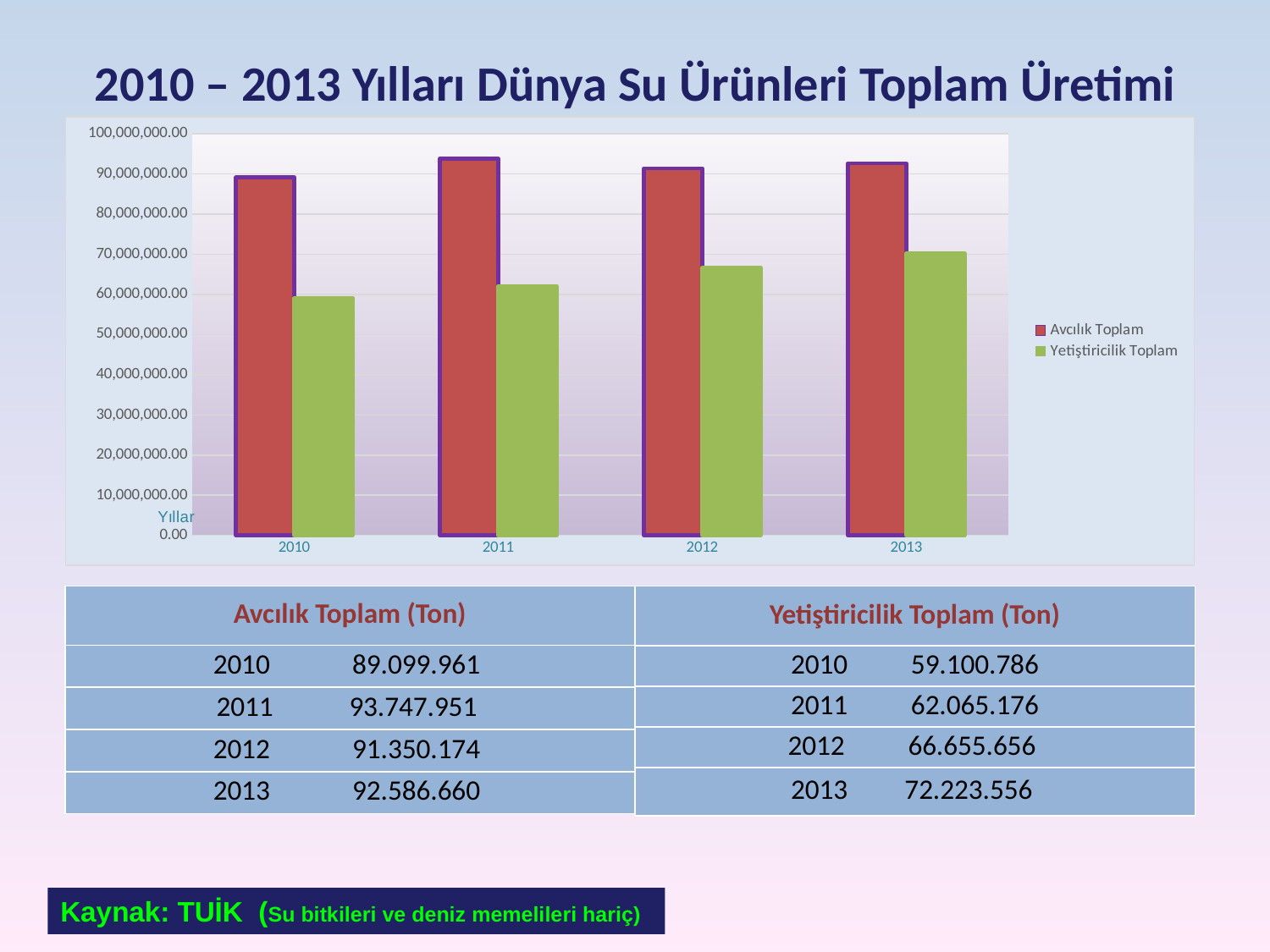
How many years are shown on the x axis of the chart? 4 In which year is Avcılık Toplam highest? 2011 In 2012, which is larger: Avcılık Toplam or Yetiştiricilik Toplam? Avcılık Toplam What colour are the Avcılık Toplam bars in the chart? red What kind of chart is shown on the slide? bar chart What is the Avcılık Toplam value for 2010? 89.099.961 Does Yetiştiricilik Toplam rise or fall from 2010 to 2013? rises What is the difference between Avcılık Toplam in 2011 and in 2010? 4.647.990 How many series does the chart legend list? 2 In which year is Yetiştiricilik Toplam lowest? 2010 Is the Yetiştiricilik Toplam value for 2011 greater or less than 70,000,000? less What is the Yetiştiricilik Toplam value for 2013? 72.223.556